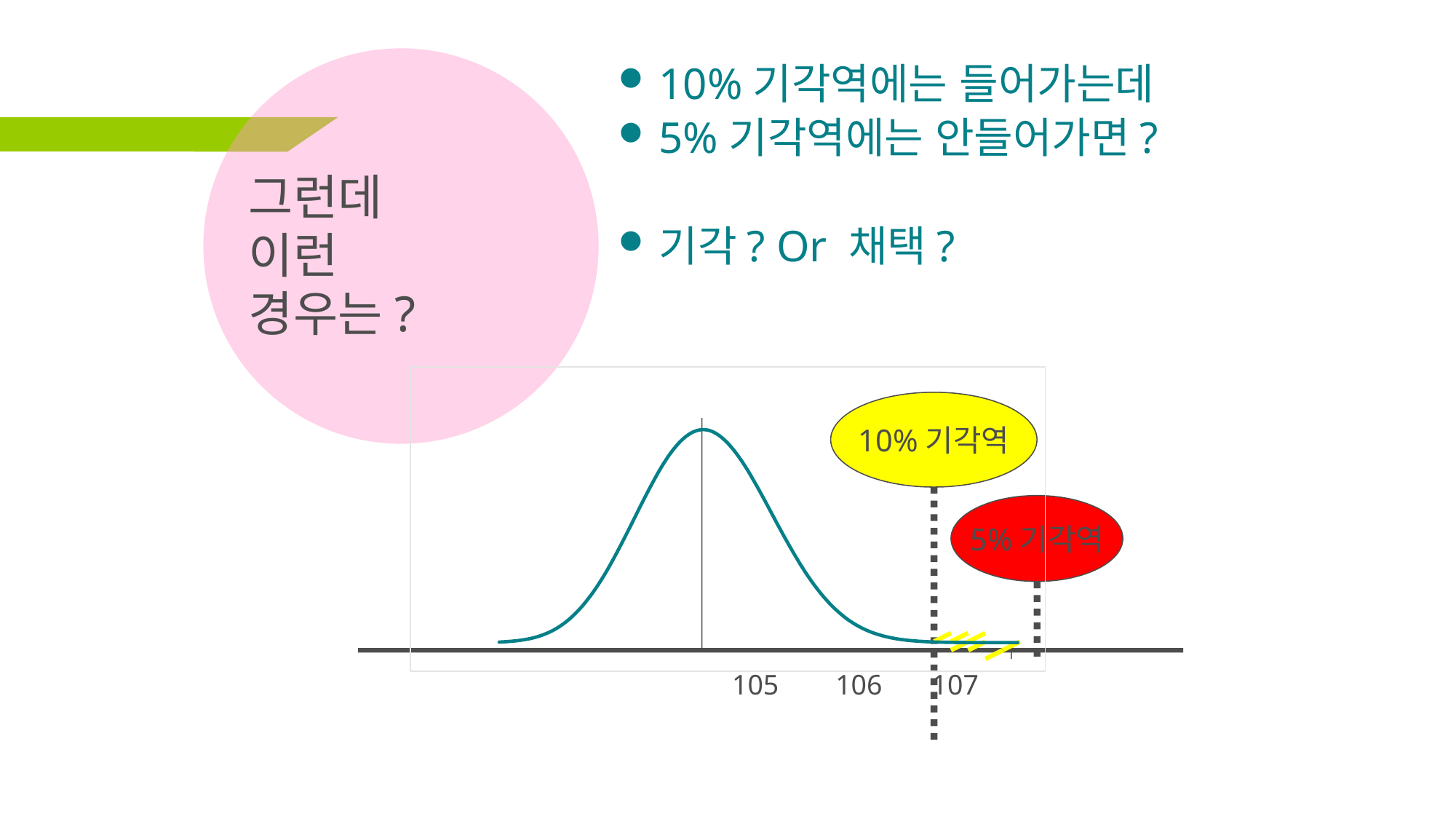
What label is written in the yellow oval on the chart? 10% 기각역 Does the curve rise or fall as the x axis moves from 105 to 107? fall Which rejection region label is shown in the red oval on the chart? 5% 기각역 What are the tick labels shown on the x axis of the chart? 105, 106, 107 Is the curve's value at 107 greater or less than its value at 105? less Which x-axis tick label is closest to the peak of the curve? 105 How many numeric tick labels are shown on the x axis of the chart? 3 What kind of chart is shown on the slide? line chart Which of the two dashed vertical lines is further to the right on the x axis, the one for the 10% 기각역 or the one for the 5% 기각역? 5% 기각역